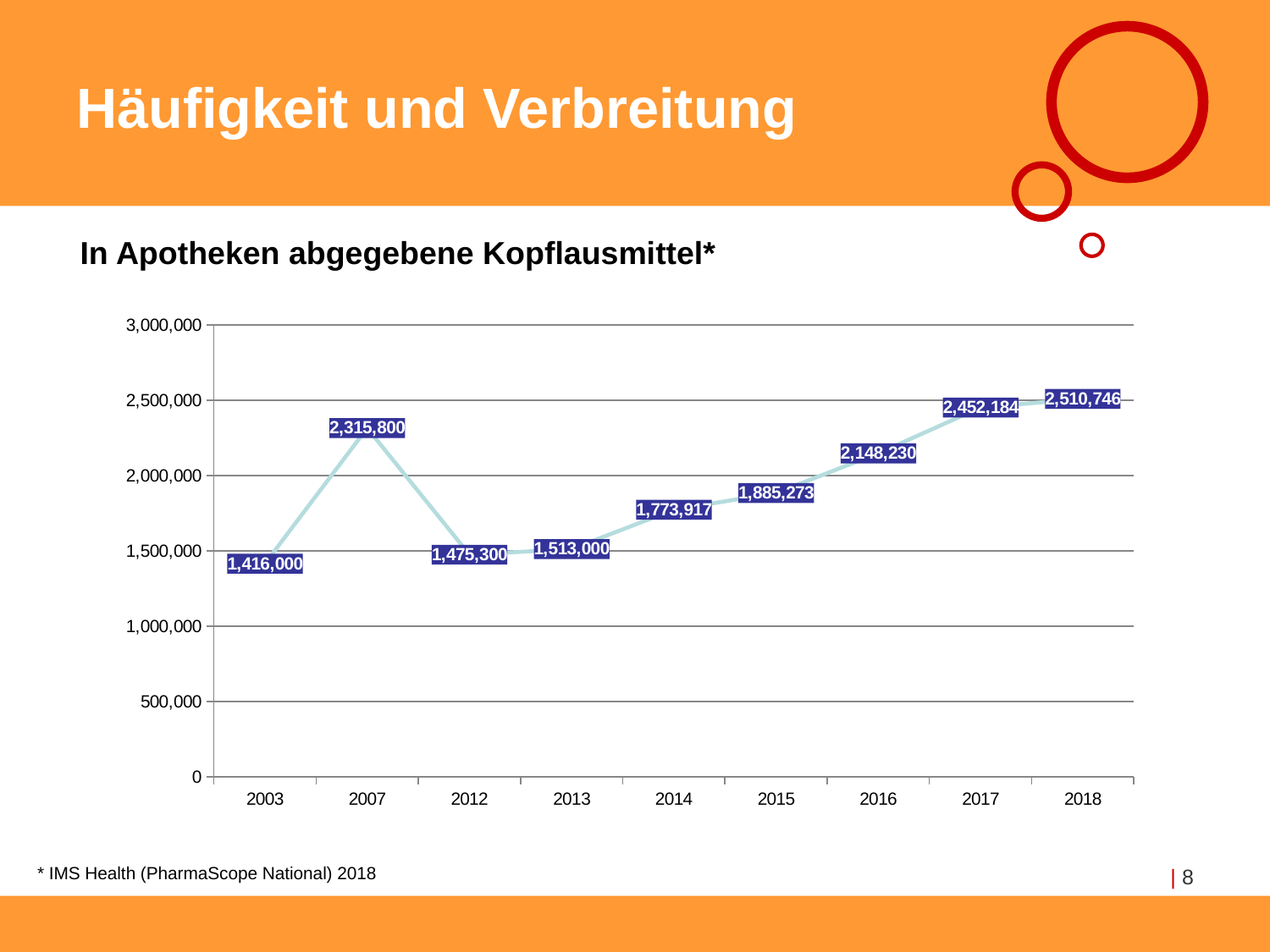
Which year has the lowest value? 2003 What value is shown for 2007? 2,315,800 Is the value for 2014 greater or less than 1,500,000? greater Which is larger, the value for 2007 or the value for 2016? 2007 Which year has the highest value? 2018 What value is shown for 2018? 2,510,746 What value is shown for 2003? 1,416,000 What is the difference between the values for 2018 and 2017? 58,562 What kind of chart is this? line chart How many years are shown on the x axis? 9 Do the values rise or fall from 2012 to 2018? rise What value is shown for 2015? 1,885,273